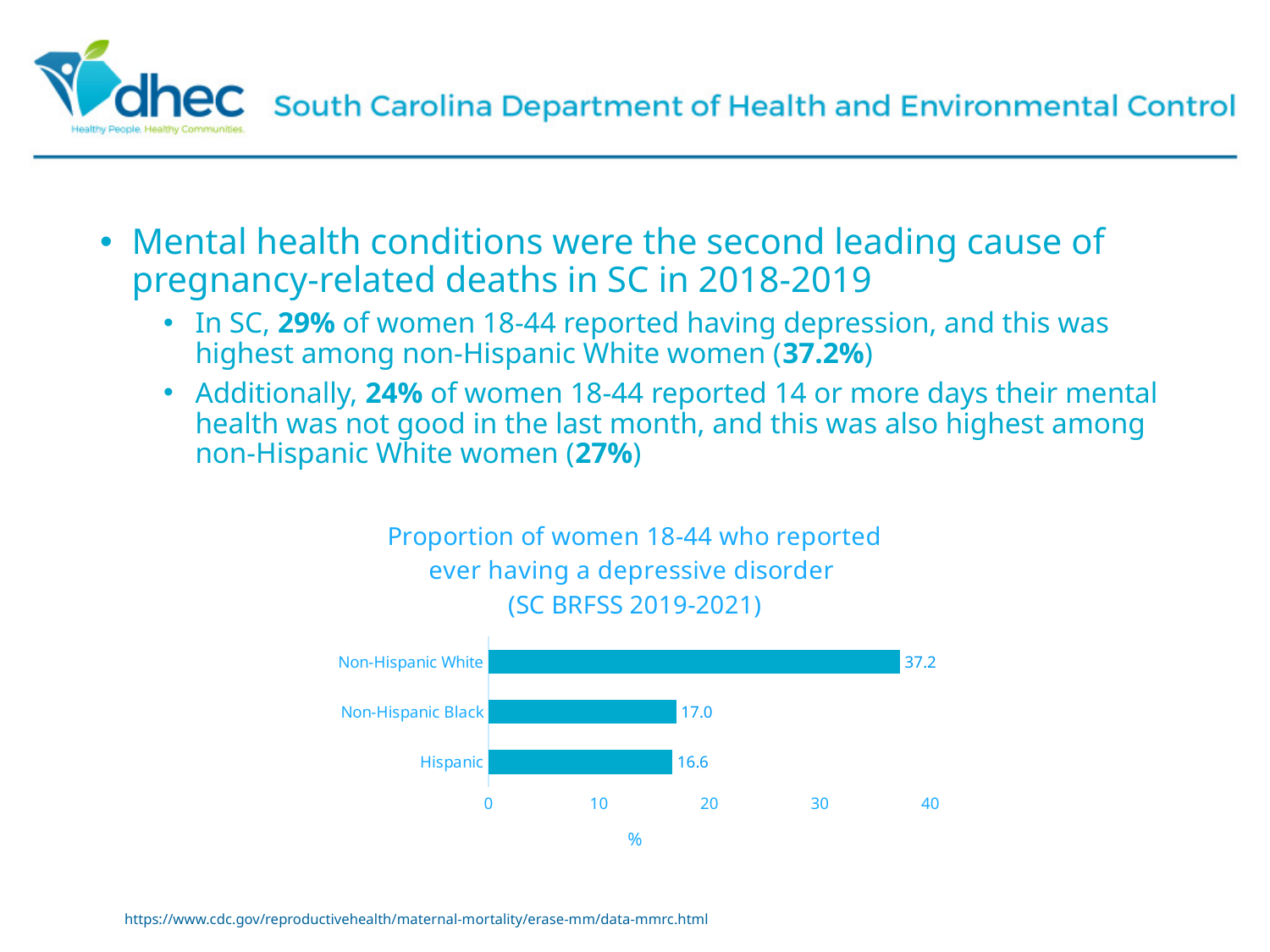
What is the title of the chart? Proportion of women 18-44 who reported ever having a depressive disorder (SC BRFSS 2019-2021) Which is larger, the value for Non-Hispanic White or the value for Hispanic? Non-Hispanic White What is the difference between the values for Non-Hispanic White and Non-Hispanic Black? 20.2 What is the value for Non-Hispanic Black in the chart? 17.0 What is the value for Non-Hispanic White in the chart? 37.2 How many categories are shown in the chart? 3 Which category has the highest value in the chart? Non-Hispanic White What is the difference between the values for Non-Hispanic Black and Hispanic? 0.4 Is the value for Non-Hispanic White greater or less than 30? greater What is the value for Hispanic in the chart? 16.6 Which category has the lowest value in the chart? Hispanic What kind of chart is shown on the slide? Bar chart